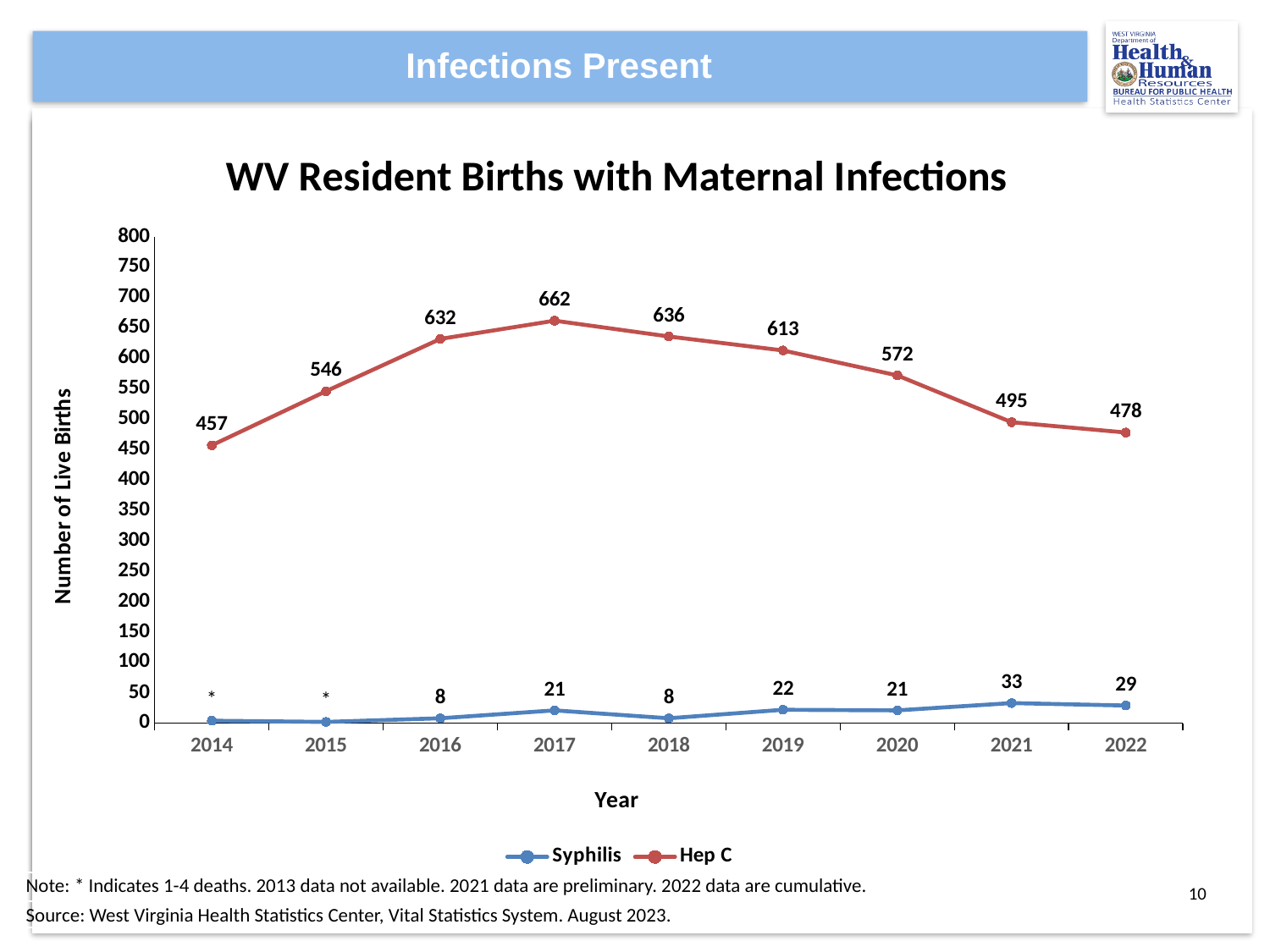
In which year is the Hep C value highest? 2017 How many series does the legend list? 2 What is the Hep C value for 2017? 662 Does the Hep C line rise or fall from 2017 to 2022? fall What is the Syphilis value for 2021? 33 How many years are shown on the x axis? 9 What kind of chart is this? line chart What is the difference between the Hep C values for 2016 and 2022? 154 In which year is the Hep C value lowest? 2014 What is the Hep C value for 2014? 457 Which is larger, the Hep C value for 2018 or for 2019? 2018 Is the Hep C value for 2020 greater or less than 600? less